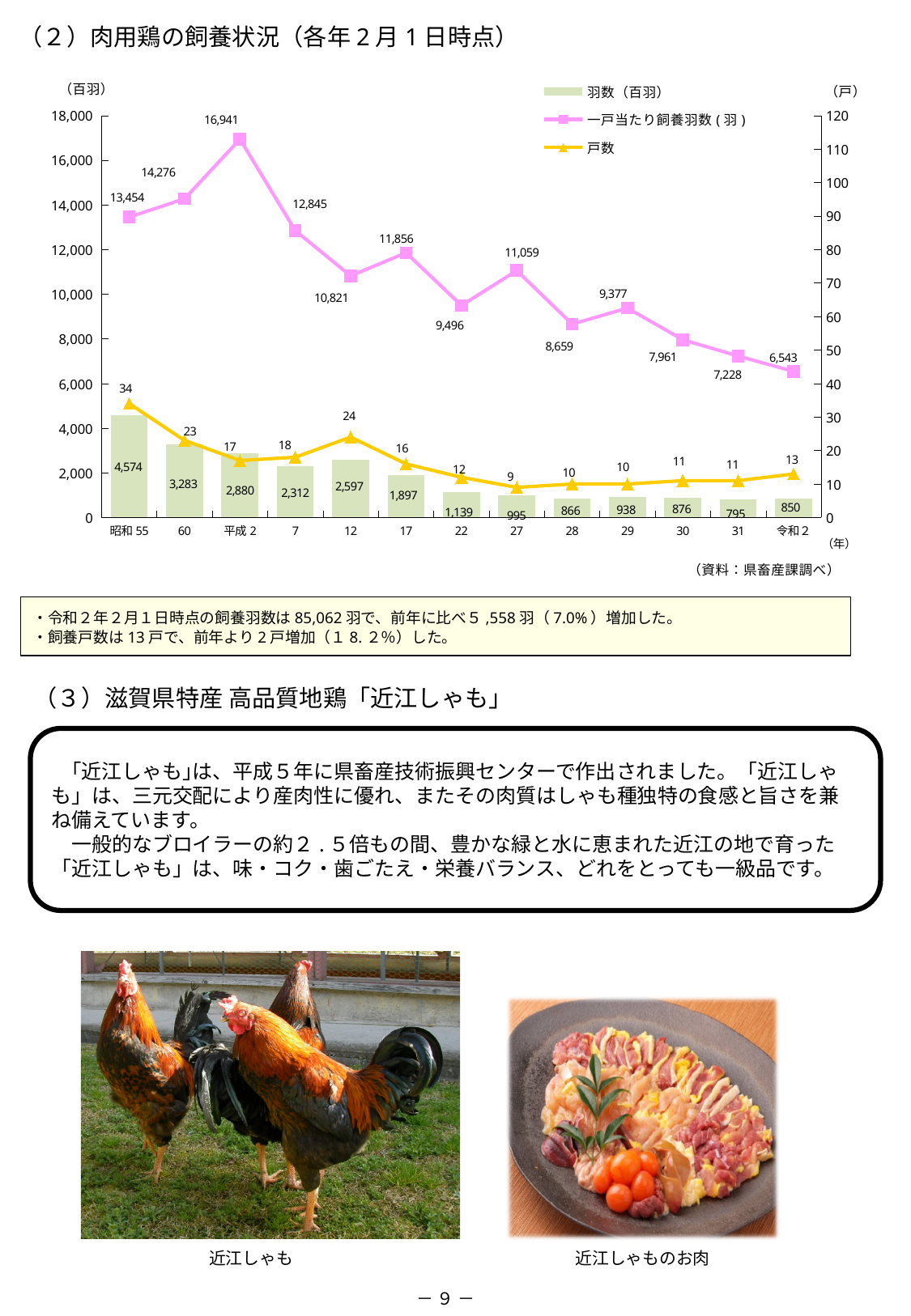
What is the value of 一戸当たり飼養羽数(羽) for 平成2? 16,941 What kind of chart is this? Combined bar and line chart Which year has the lowest value of 羽数（百羽）? 31 Which is larger, the 戸数 value for 12 or for 17? 12 How many years are shown on the x axis? 13 Does the 一戸当たり飼養羽数(羽) series generally rise or fall from 平成2 to 令和2? Fall What is the value of 戸数 for 令和2? 13 What is the difference between the 羽数（百羽） values for 昭和55 and 60? 1,291 What is the value of 羽数（百羽） for 昭和55? 4,574 Which series is drawn as bars? 羽数（百羽） Which year has the highest value of 一戸当たり飼養羽数(羽)? 平成2 How many series does the legend list? 3